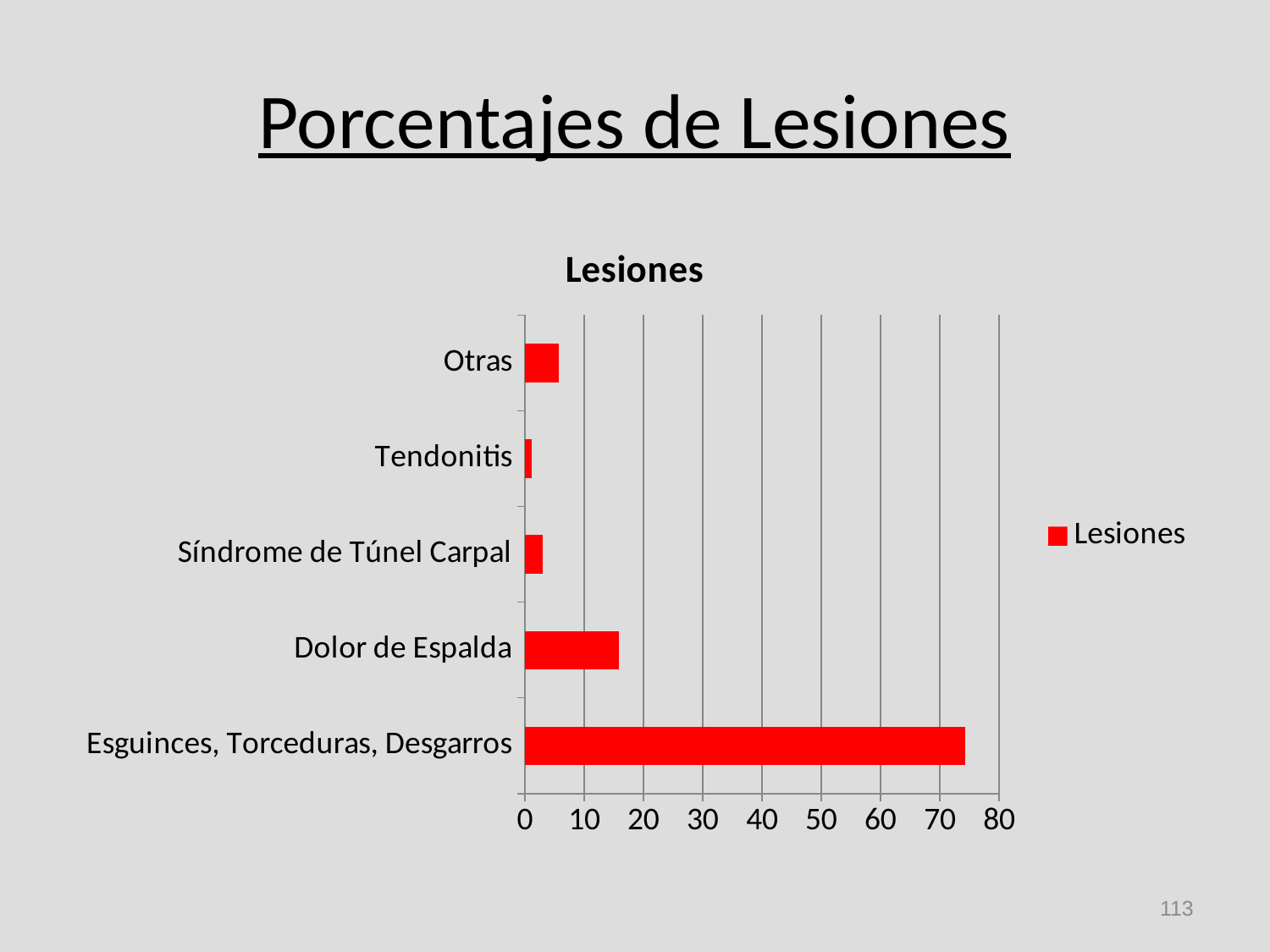
Is the value for Esguinces, Torceduras, Desgarros greater or less than 70? greater Which category has the highest value? Esguinces, Torceduras, Desgarros Which category has the lowest value? Tendonitis How many series does the legend list? 1 Is the value for Dolor de Espalda greater or less than 10? greater What kind of chart is shown on the slide? Bar chart How many categories are plotted in the chart? 5 What is the title of the chart? Lesiones Which is larger, the value for Otras or the value for Síndrome de Túnel Carpal? Otras Is the value for Dolor de Espalda greater or less than 20? less Which is larger, the value for Dolor de Espalda or the value for Otras? Dolor de Espalda